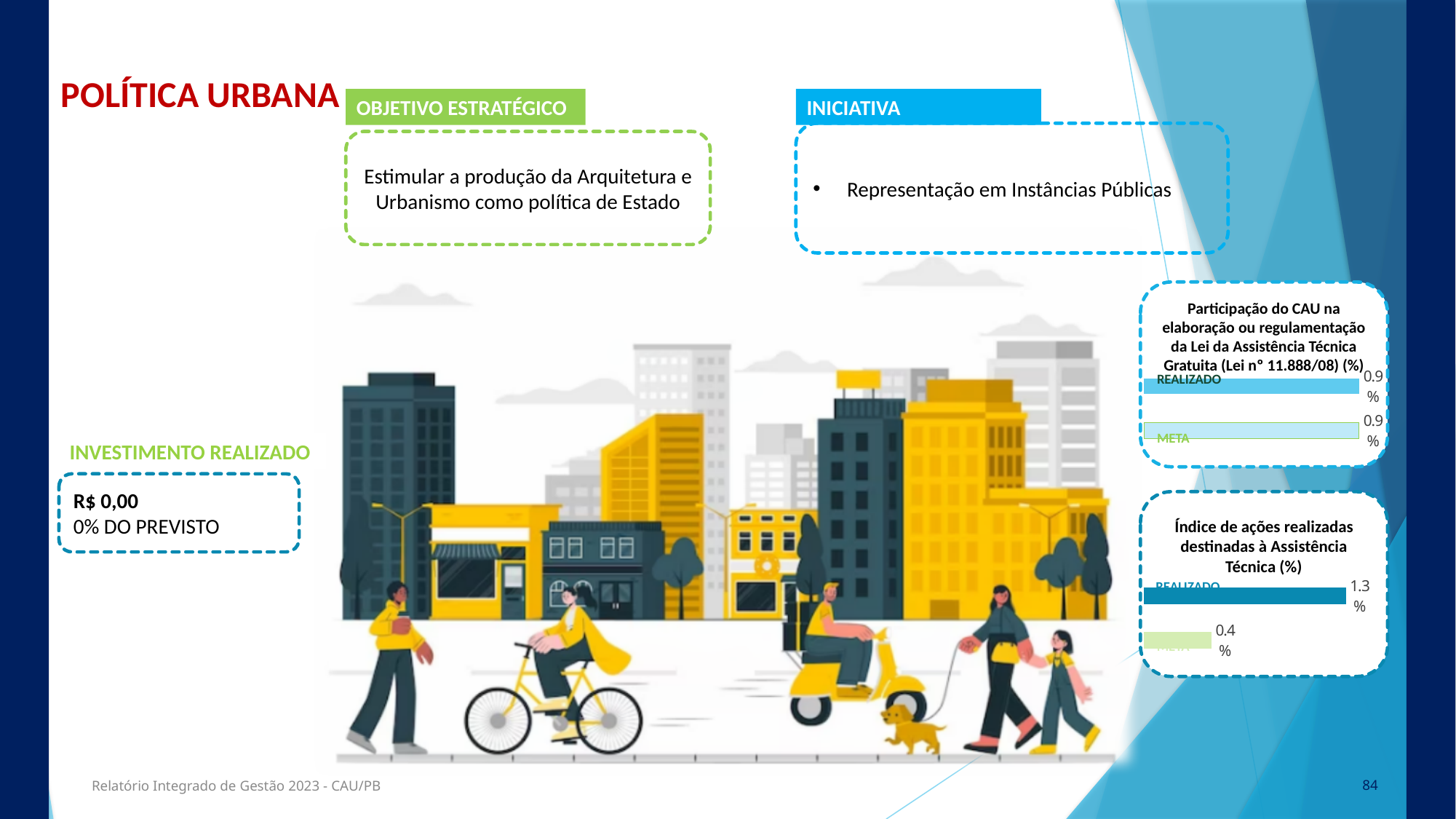
In the chart titled 'Índice de ações realizadas destinadas à Assistência Técnica (%)', what is the difference between REALIZADO and META? 0.9% In the chart titled 'Índice de ações realizadas destinadas à Assistência Técnica (%)', which category has the highest value? REALIZADO What are the two category labels used in the chart titled 'Índice de ações realizadas destinadas à Assistência Técnica (%)'? REALIZADO and META How many bar charts are shown on the slide? 2 In the chart titled 'Participação do CAU na elaboração ou regulamentação da Lei da Assistência Técnica Gratuita (Lei nº 11.888/08) (%)', what is the value for META? 0.9% How many bars are shown in the chart titled 'Índice de ações realizadas destinadas à Assistência Técnica (%)'? 2 What kind of chart is the one titled 'Participação do CAU na elaboração ou regulamentação da Lei da Assistência Técnica Gratuita (Lei nº 11.888/08) (%)'? Bar chart In the chart titled 'Índice de ações realizadas destinadas à Assistência Técnica (%)', which is larger, REALIZADO or META? REALIZADO In the chart titled 'Participação do CAU na elaboração ou regulamentação da Lei da Assistência Técnica Gratuita (Lei nº 11.888/08) (%)', what is the value for REALIZADO? 0.9% In the chart titled 'Índice de ações realizadas destinadas à Assistência Técnica (%)', which category has the lowest value? META In the chart titled 'Índice de ações realizadas destinadas à Assistência Técnica (%)', what is the value for REALIZADO? 1.3% In the chart titled 'Índice de ações realizadas destinadas à Assistência Técnica (%)', what is the value for META? 0.4%